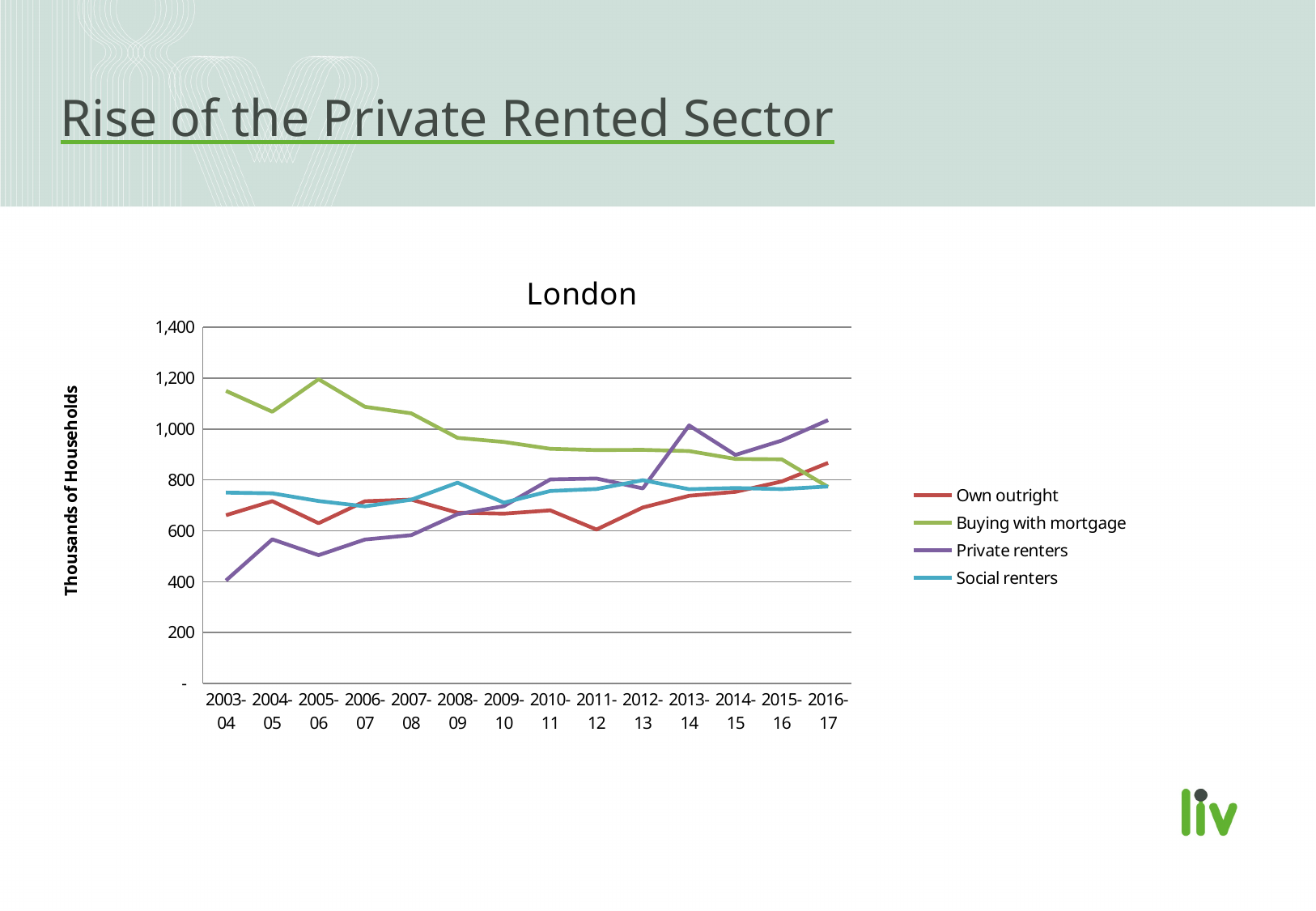
What kind of chart is shown on the slide? Line chart Does the Private renters line rise or fall from 2003-04 to 2016-17? Rise Is the value for Buying with mortgage in 2005-06 greater or less than 1,000? greater How many series does the legend list? 4 What is the title of the chart? London How many time periods are shown along the x axis? 14 Does the Buying with mortgage line rise or fall from 2003-04 to 2016-17? Fall Is the value for Private renters in 2003-04 greater or less than 600? less What is the label on the vertical axis? Thousands of Households Is the value for Own outright in 2011-12 greater or less than 800? less Which series has the lowest value in 2003-04? Private renters Which series has the highest value in 2003-04? Buying with mortgage